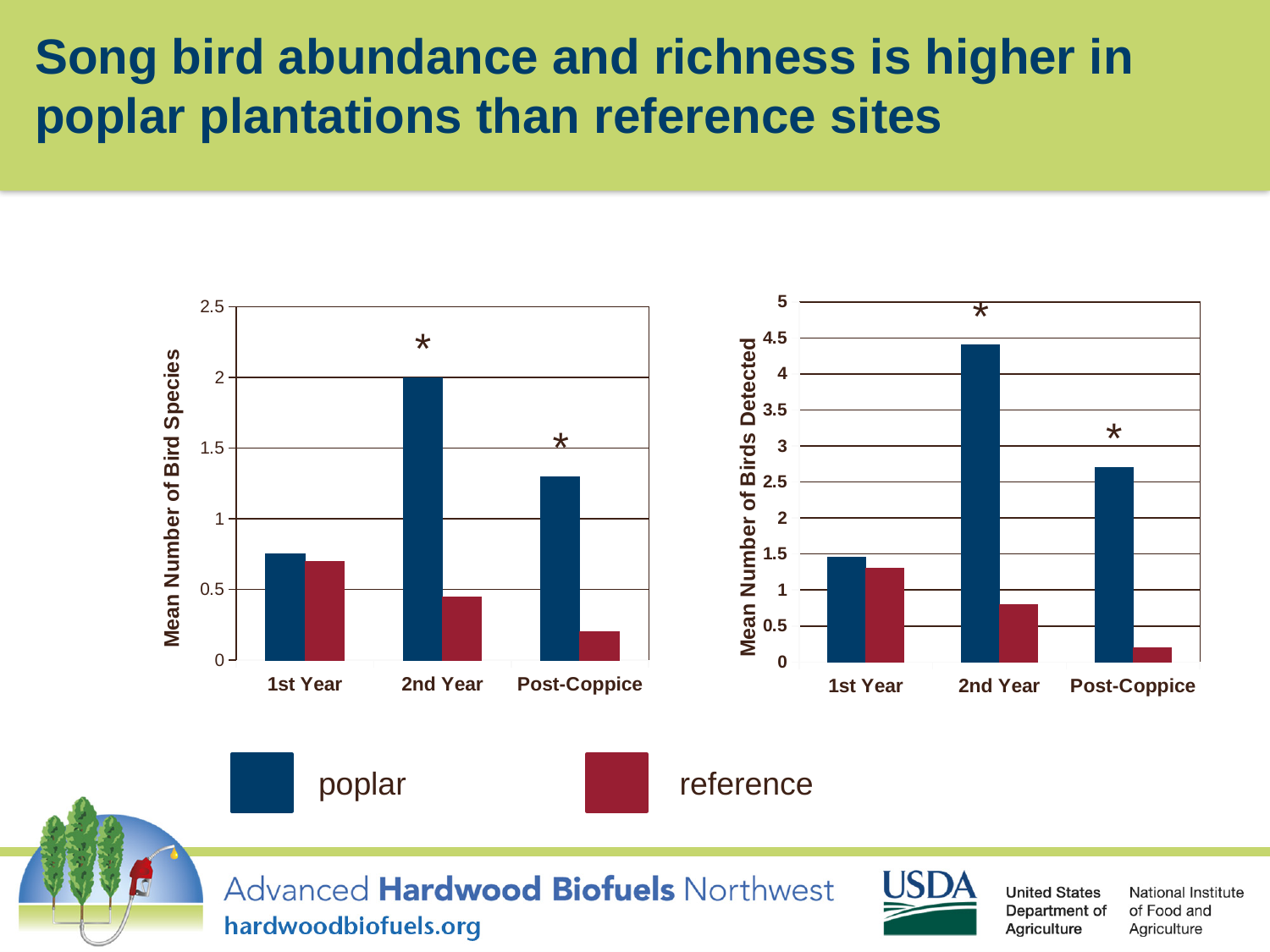
On the right chart (Mean Number of Birds Detected), which is larger for Post-Coppice, poplar or reference? poplar How many series does the legend list for the charts? 2 On the left chart (Mean Number of Bird Species), what is the value for poplar in the 2nd Year? 2 On the right chart (Mean Number of Birds Detected), is the poplar value for the 2nd Year greater or less than 4? greater What colour represents the reference series in the legend? dark red On the left chart (Mean Number of Bird Species), which category has the highest poplar bar? 2nd Year How many categories are shown on the x axis of the left chart (Mean Number of Bird Species)? 3 On the right chart (Mean Number of Birds Detected), which category has the lowest reference bar? Post-Coppice On the right chart (Mean Number of Birds Detected), is the reference value for Post-Coppice greater or less than 0.5? less On the left chart (Mean Number of Bird Species), is the poplar value for Post-Coppice greater or less than 1? greater On the left chart (Mean Number of Bird Species), which is larger in the 2nd Year, poplar or reference? poplar What kind of chart is the right chart (Mean Number of Birds Detected)? bar chart